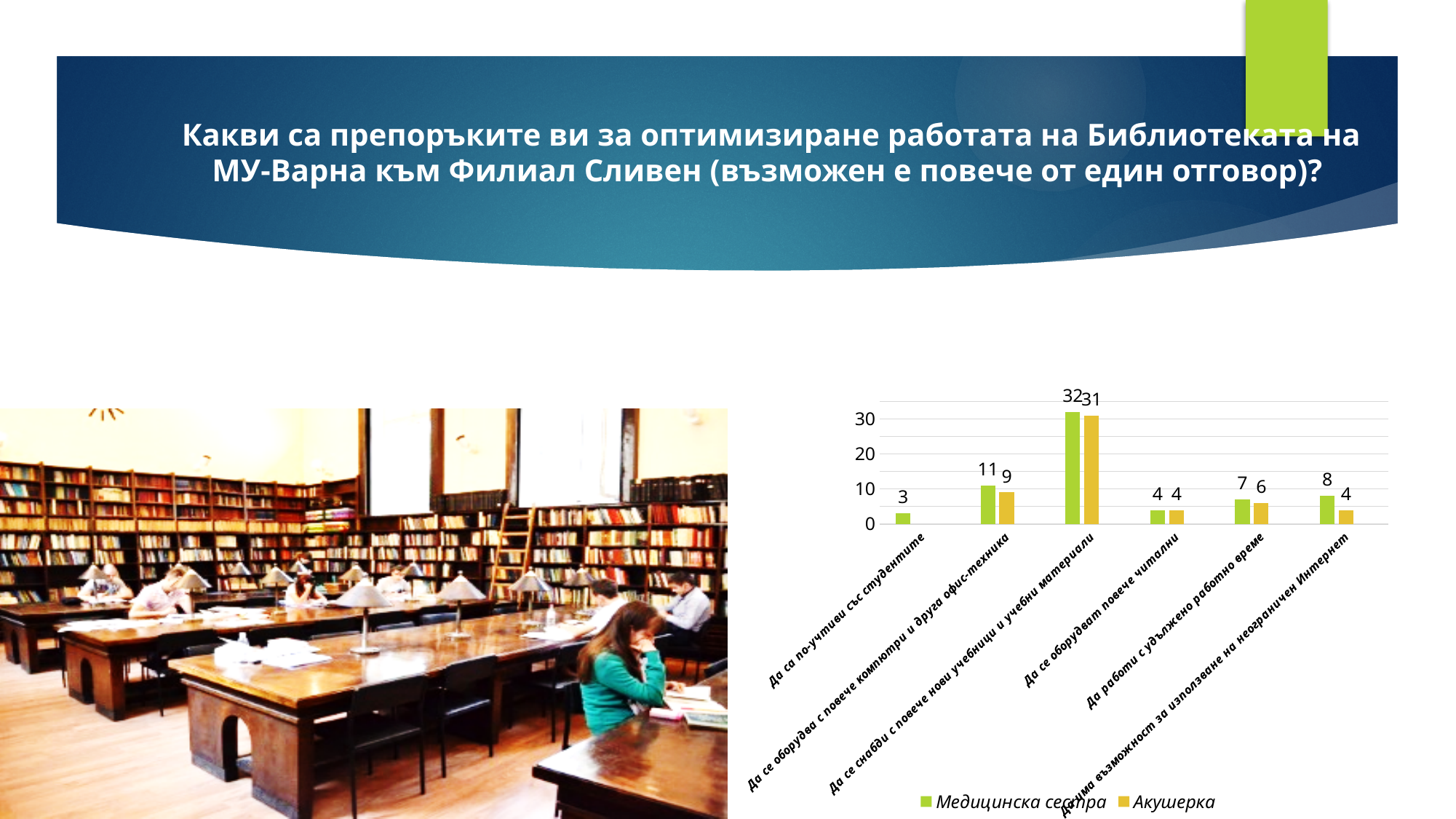
Which category has the lowest value for Медицинска сестра? Да са по-учтиви със студентите What is the difference between the Медицинска сестра and Акушерка values in the category 'Да има възможност за използване на неограничен Интернет'? 4 Which series has the larger value in the category 'Да се оборудва с повече компютри и друга офис-техника'? Медицинска сестра Is the value for Акушерка in the category 'Да се снабди с повече нови учебници и учебни материали' greater or less than 20? greater Which category has the highest value for Медицинска сестра? Да се снабди с повече нови учебници и учебни материали How many series does the chart legend list? 2 How many categories are shown on the x axis of the chart? 6 What is the value for Медицинска сестра in the category 'Да се снабди с повече нови учебници и учебни материали'? 32 Which series is shown in green in the chart? Медицинска сестра What type of chart is shown on the slide? bar chart What is the value for Акушерка in the category 'Да има възможност за използване на неограничен Интернет'? 4 What is the value for Акушерка in the category 'Да се оборудва с повече компютри и друга офис-техника'? 9